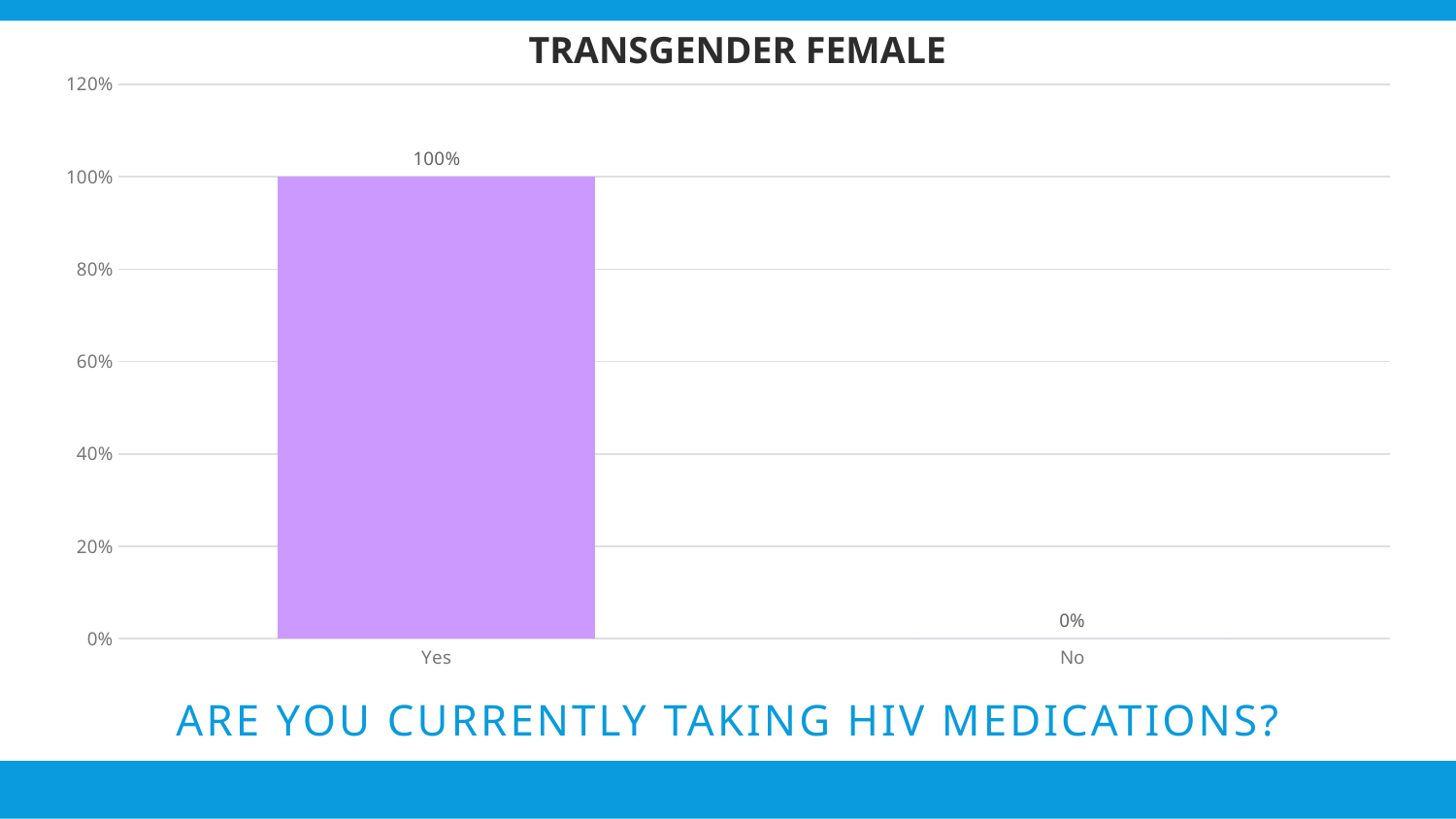
What is the title of the chart? TRANSGENDER FEMALE Which category has the lowest value? No What is the value for No? 0% What is the value for Yes? 100% What kind of chart is shown on the slide? bar chart Which is larger, the value for Yes or the value for No? Yes Do the values rise or fall from Yes to No along the x axis? fall What is the difference between the values for Yes and No? 100% Is the value for Yes greater or less than 80%? greater Which category has the highest value? Yes How many categories are shown on the x axis? 2 What is the highest value shown on the y axis? 120%